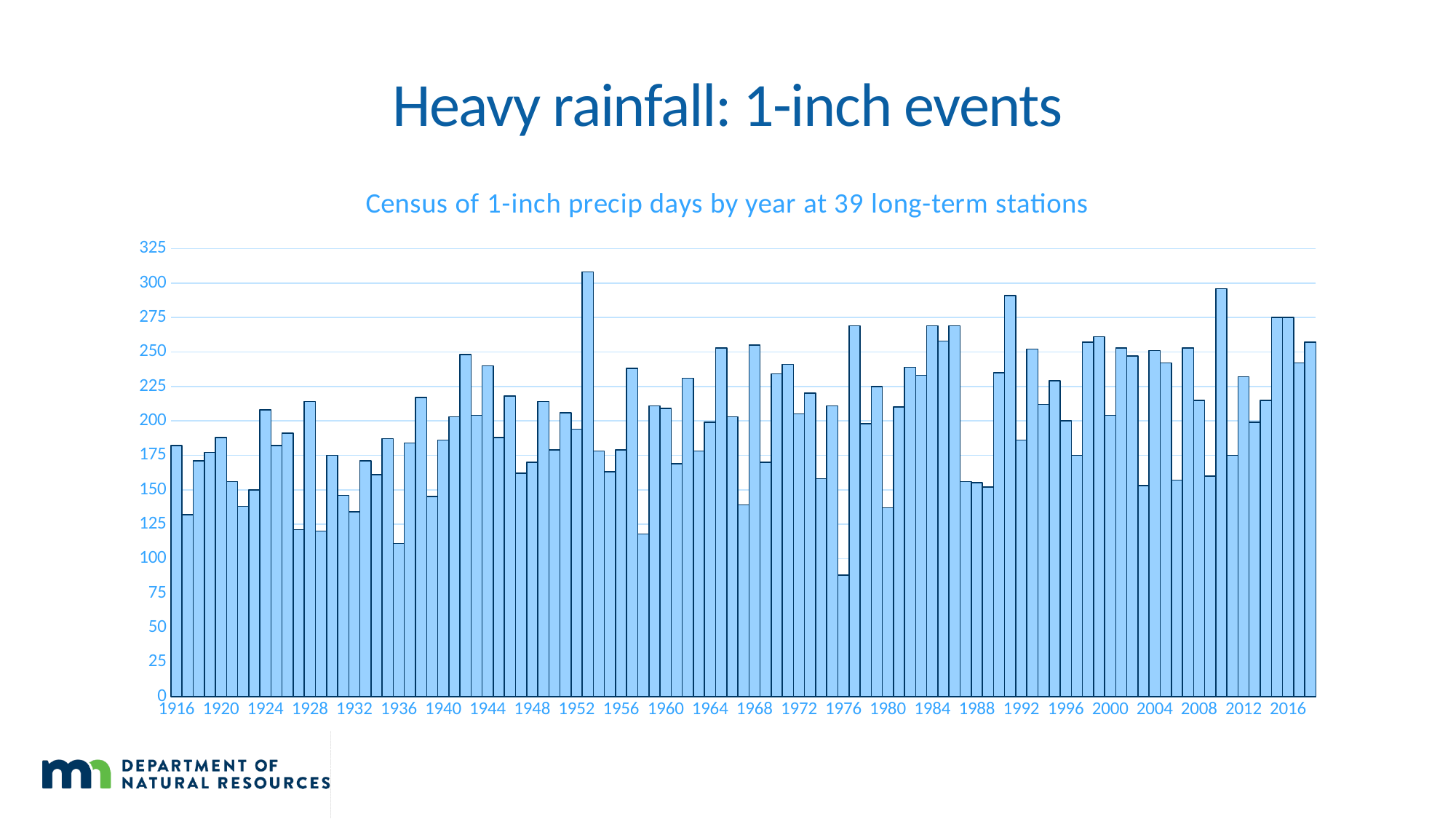
Is the value for the tallest bar greater or less than 300? greater Is the value for 2008 greater or less than 225? less Which year has the lowest number of 1-inch precip days? 1976 Is the value for 1936 greater or less than 125? less Do the number of 1-inch precip days generally rise or fall from 1916 to 2016? rise How many long-term stations does the chart subtitle say the census covers? 39 What kind of chart is shown on the slide? bar chart